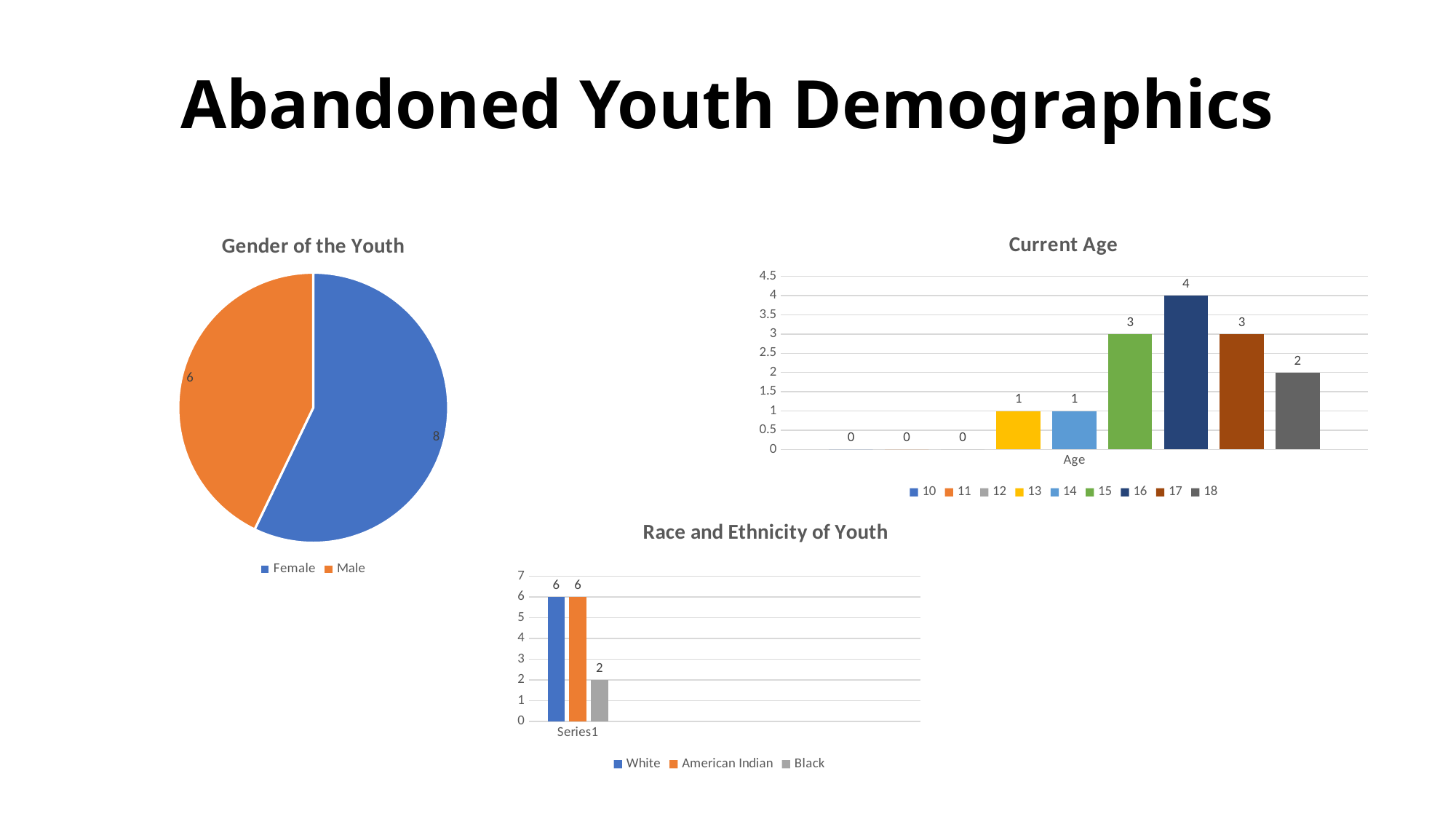
In the 'Gender of the Youth' chart, what kind of chart is shown? pie chart In the 'Gender of the Youth' chart, what is the difference between the Female and Male values? 2 In the 'Current Age' chart, which age has the highest value? 16 In the 'Race and Ethnicity of Youth' chart, what kind of chart is shown? bar chart In the 'Current Age' chart, how many series does the legend list? 9 In the 'Race and Ethnicity of Youth' chart, what is the value for Black? 2 In the 'Current Age' chart, what is the value for age 16? 4 In the 'Gender of the Youth' chart, what is the value for Male? 6 In the 'Current Age' chart, which is larger, the value for age 15 or the value for age 14? 15 In the 'Gender of the Youth' chart, what is the value for Female? 8 In the 'Race and Ethnicity of Youth' chart, which category has the lowest value? Black In the 'Current Age' chart, what is the value for age 18? 2